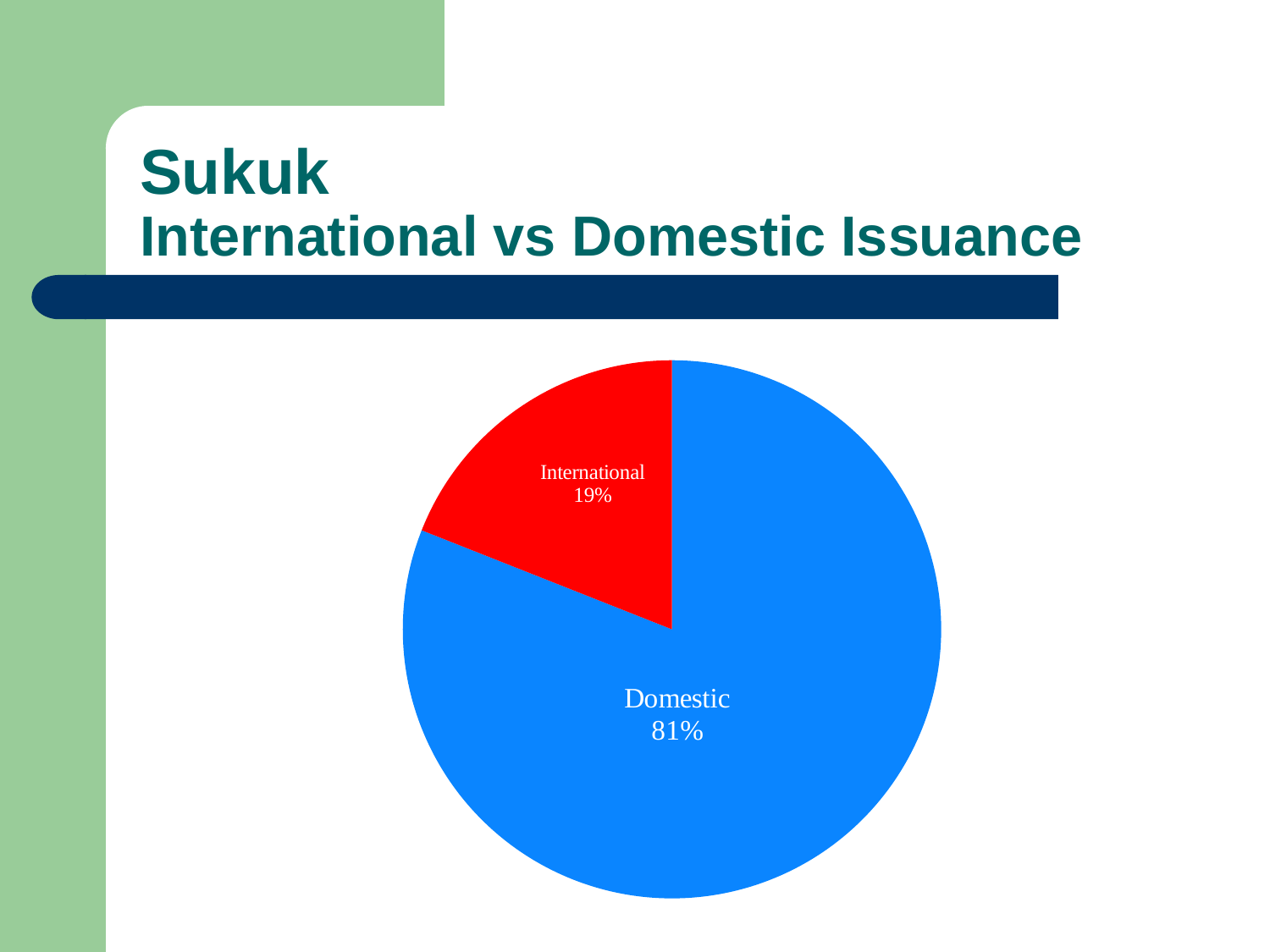
What share of the pie does International represent? 19% How many slices does the pie chart have? 2 What is the difference in percentage points between the Domestic and International slices? 62 What colour is the International slice? red What share of the pie does Domestic represent? 81% What is the combined share of the Domestic and International slices? 100% Which slice is the smallest? International What colour is the Domestic slice? blue Which slice is the largest? Domestic Which is larger, the Domestic slice or the International slice? Domestic What kind of chart is shown on the slide? pie chart